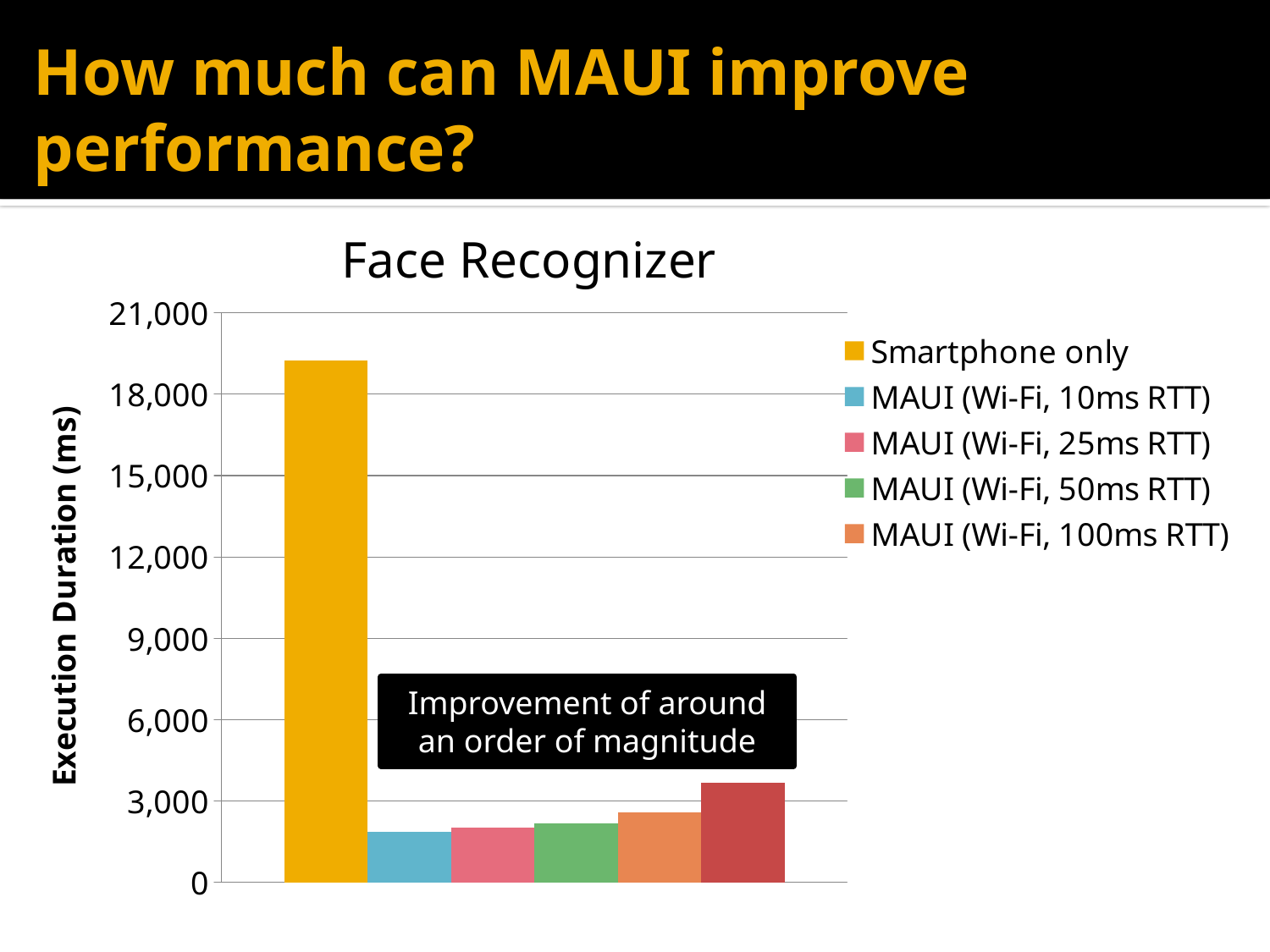
What is the title of the chart? Face Recognizer Which is larger, the value for Smartphone only or the value for MAUI (Wi-Fi, 10ms RTT)? Smartphone only Is the value for MAUI (Wi-Fi, 100ms RTT) greater or less than 3,000? less Which is larger, the value for MAUI (Wi-Fi, 100ms RTT) or the value for MAUI (Wi-Fi, 10ms RTT)? MAUI (Wi-Fi, 100ms RTT) Is the value for Smartphone only greater or less than 21,000? less What kind of chart is shown on the slide? bar chart How many series does the legend list? 5 Is the value for Smartphone only greater or less than 18,000? greater Which series has the highest execution duration? Smartphone only Do the MAUI execution durations rise or fall as the RTT increases from 10ms to 100ms? rise How many bars are plotted in the chart? 6